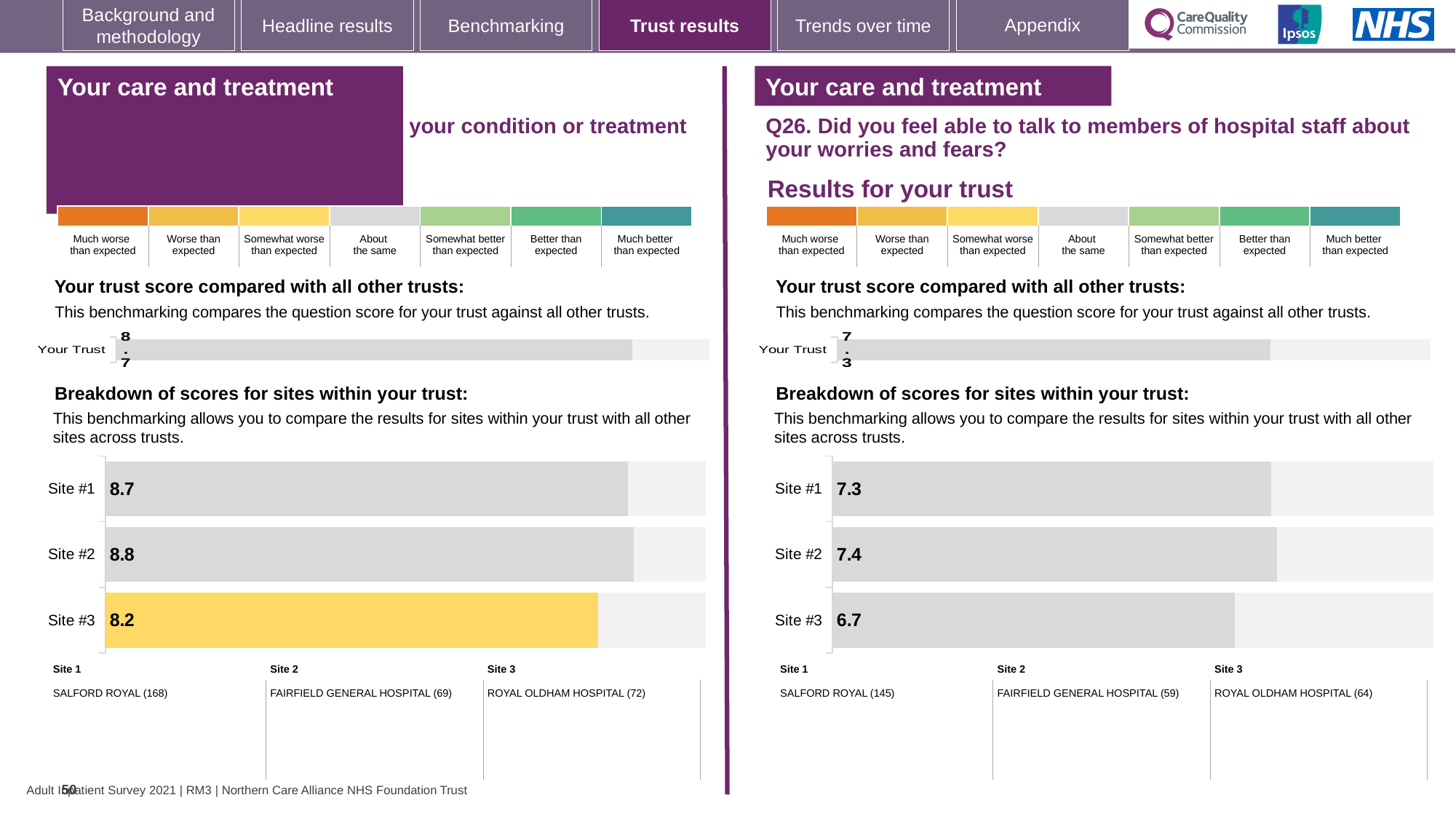
In the Q26 'Breakdown of scores for sites within your trust' chart, how many sites are shown? 3 In the left-hand 'Breakdown of scores for sites within your trust' chart, which site has the highest score? Site #2 In the Q26 'Your trust score compared with all other trusts' chart, what is the score for Your Trust? 7.3 In the left-hand 'Your trust score compared with all other trusts' chart, what is the score for Your Trust? 8.7 In the left-hand 'Breakdown of scores for sites within your trust' chart, what is the score for Site #1? 8.7 In the left-hand 'Breakdown of scores for sites within your trust' chart, what is the score for Site #3? 8.2 In the Q26 'Breakdown of scores for sites within your trust' chart, what is the difference between the scores for Site #1 and Site #3? 0.6 In the left-hand 'Breakdown of scores for sites within your trust' chart, what is the difference between the scores for Site #2 and Site #3? 0.6 In the left-hand 'Breakdown of scores for sites within your trust' chart, which site's bar is coloured yellow rather than grey? Site #3 In the Q26 'Breakdown of scores for sites within your trust' chart, which site has the lowest score? Site #3 In the Q26 'Breakdown of scores for sites within your trust' chart, what is the score for Site #2? 7.4 What type of chart is the Q26 'Breakdown of scores for sites within your trust' chart? Bar chart